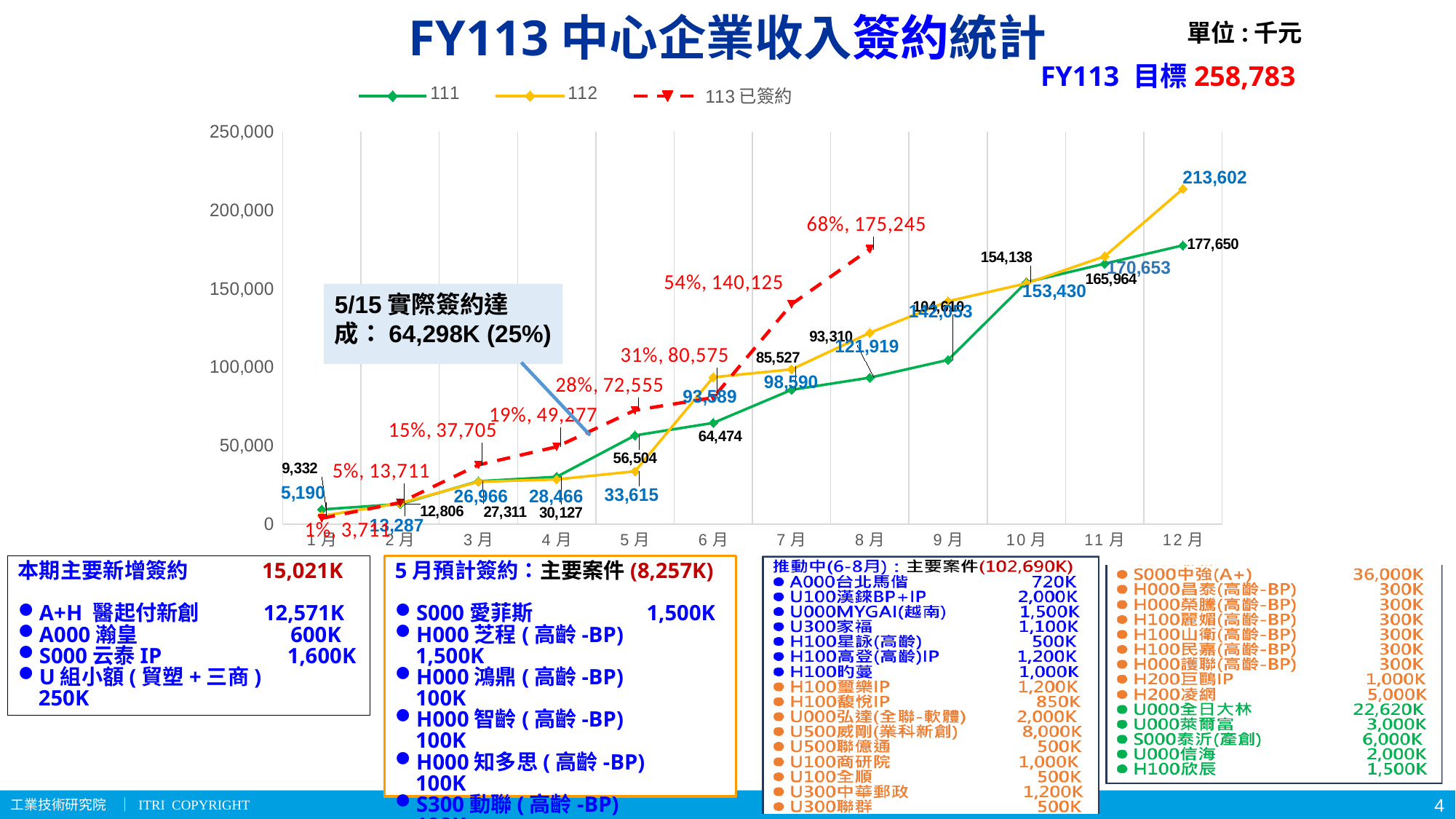
How many series does the legend list? 3 Does series 112 generally rise or fall from 1月 to 12月? rise How many months are shown on the x axis? 12 What kind of chart is shown on the slide? line chart In 5月, which series has the larger value, 111 or 112? 111 What is the value for series 112 in 12月? 213,602 What is the value for series 111 in 1月? 9,332 In which month does series 112 reach its highest value? 12月 What is the value for series 113 已簽約 in 8月? 175,245 What is the difference between series 112 and series 111 in 12月? 35,952 What is the value for series 112 in 1月? 5,190 What is the value for series 111 in 12月? 177,650